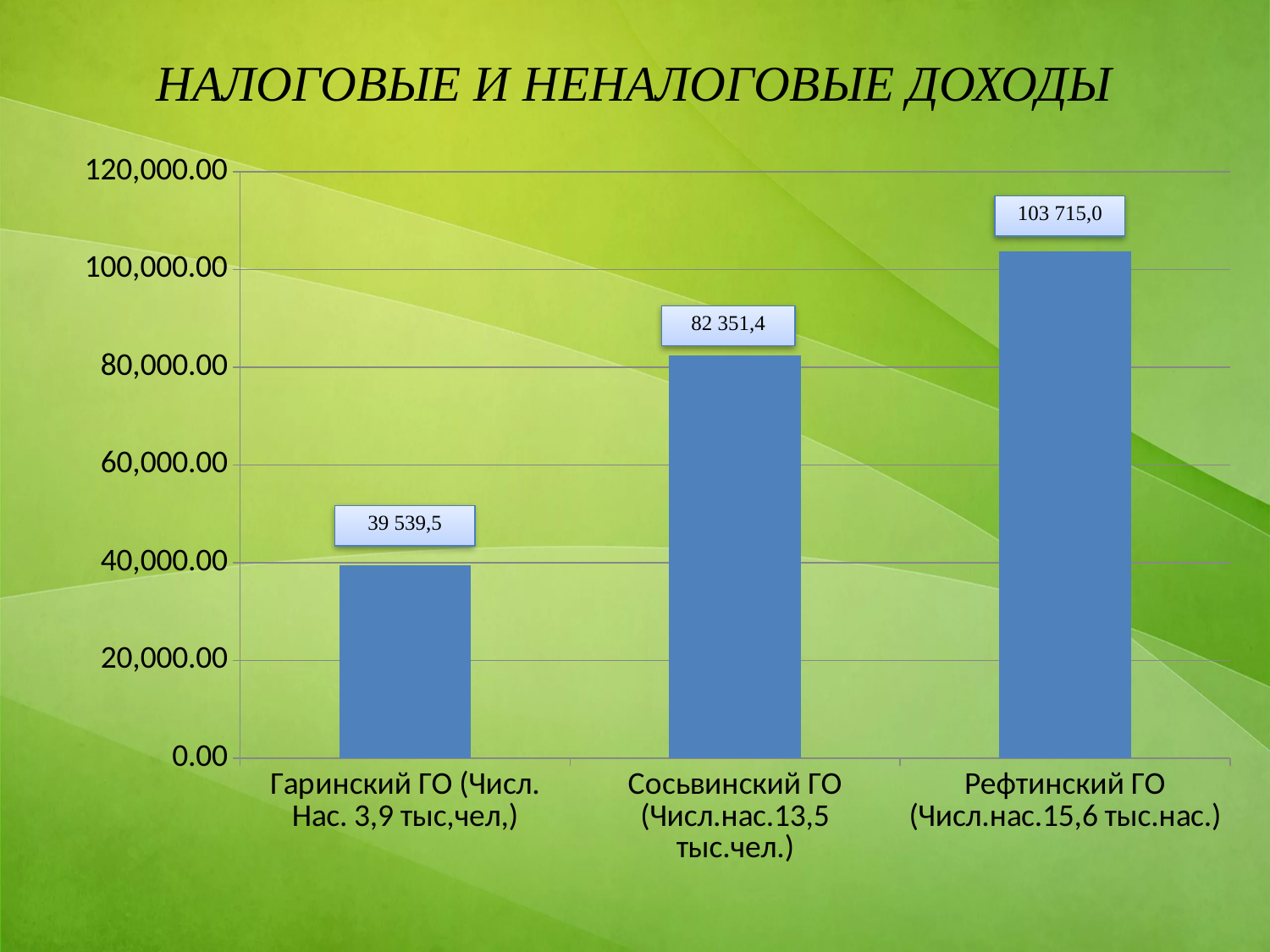
How many categories are shown in the chart? 3 Which category has the highest value? Рефтинский ГО Which is larger, the value for Сосьвинский ГО or the value for Рефтинский ГО? Рефтинский ГО What is the value for Гаринский ГО? 39 539,5 What is the value for Рефтинский ГО? 103 715,0 What is the title of the chart? НАЛОГОВЫЕ И НЕНАЛОГОВЫЕ ДОХОДЫ Which category has the lowest value? Гаринский ГО What kind of chart is shown on the slide? bar chart What is the difference between the values for Сосьвинский ГО and Гаринский ГО? 42 811,9 What is the value for Сосьвинский ГО? 82 351,4 Is the value for Сосьвинский ГО greater or less than 100,000.00? less What is the difference between the values for Рефтинский ГО and Гаринский ГО? 64 175,5